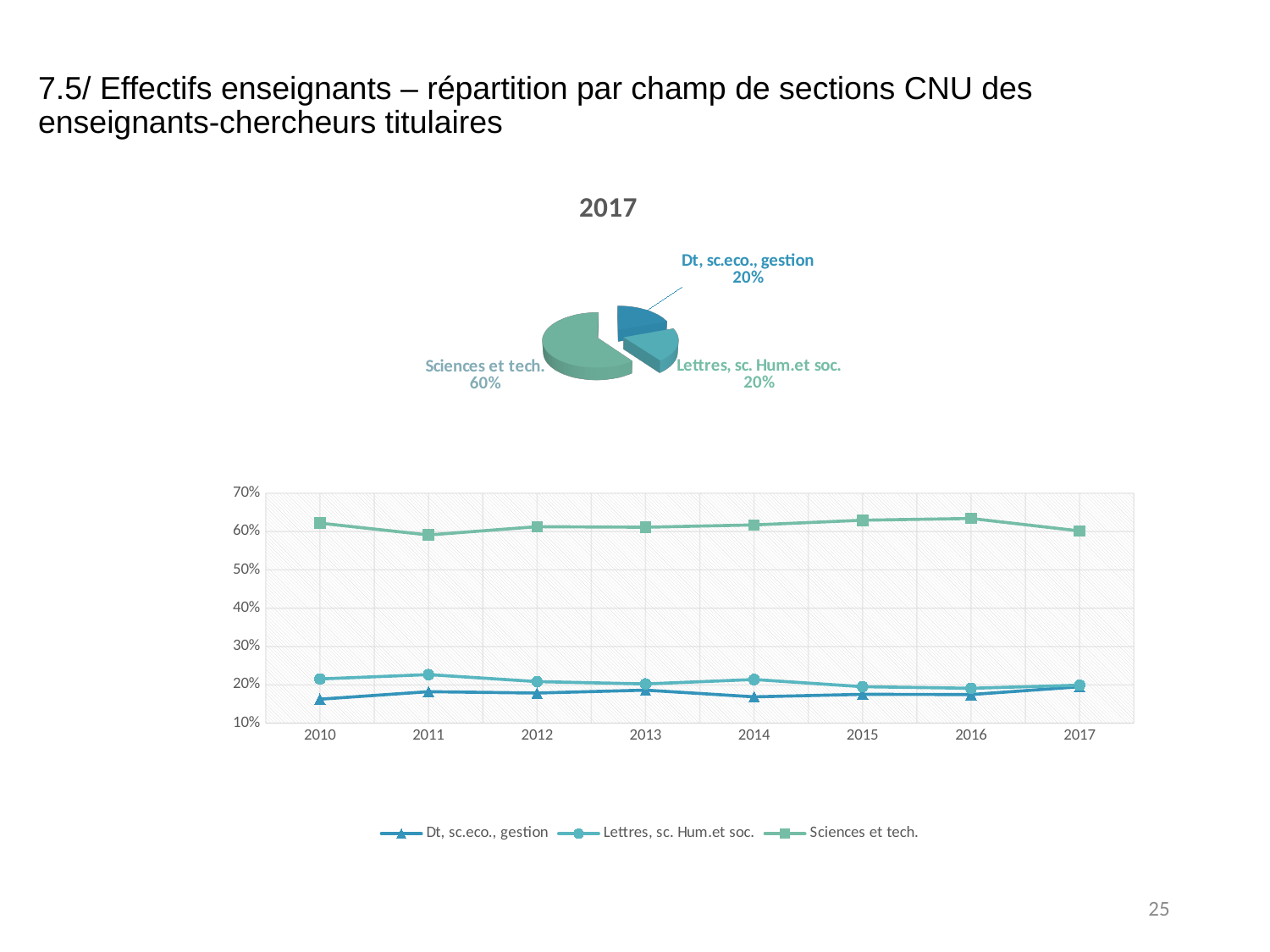
In the line chart at the bottom of the slide, how many series does the legend list? 3 In the line chart at the bottom of the slide, which series has the highest values across all years? Sciences et tech. In the line chart at the bottom of the slide, how many years are shown on the x axis? 8 In the pie chart titled 2017, how many slices are there? 3 In the pie chart titled 2017, what is the difference between the share of Sciences et tech. and the share of Lettres, sc. Hum.et soc.? 40% What kind of chart is the chart at the bottom of the slide? line chart In the pie chart titled 2017, what share does Dt, sc.eco., gestion have? 20% In the line chart at the bottom of the slide, is the value for Sciences et tech. in 2016 greater or less than 60%? greater In the pie chart titled 2017, what share does Sciences et tech. have? 60% In the pie chart titled 2017, which category has the largest slice? Sciences et tech. In the line chart at the bottom of the slide, is the value for Dt, sc.eco., gestion in 2010 greater or less than 20%? less What kind of chart is the chart at the top of the slide? pie chart